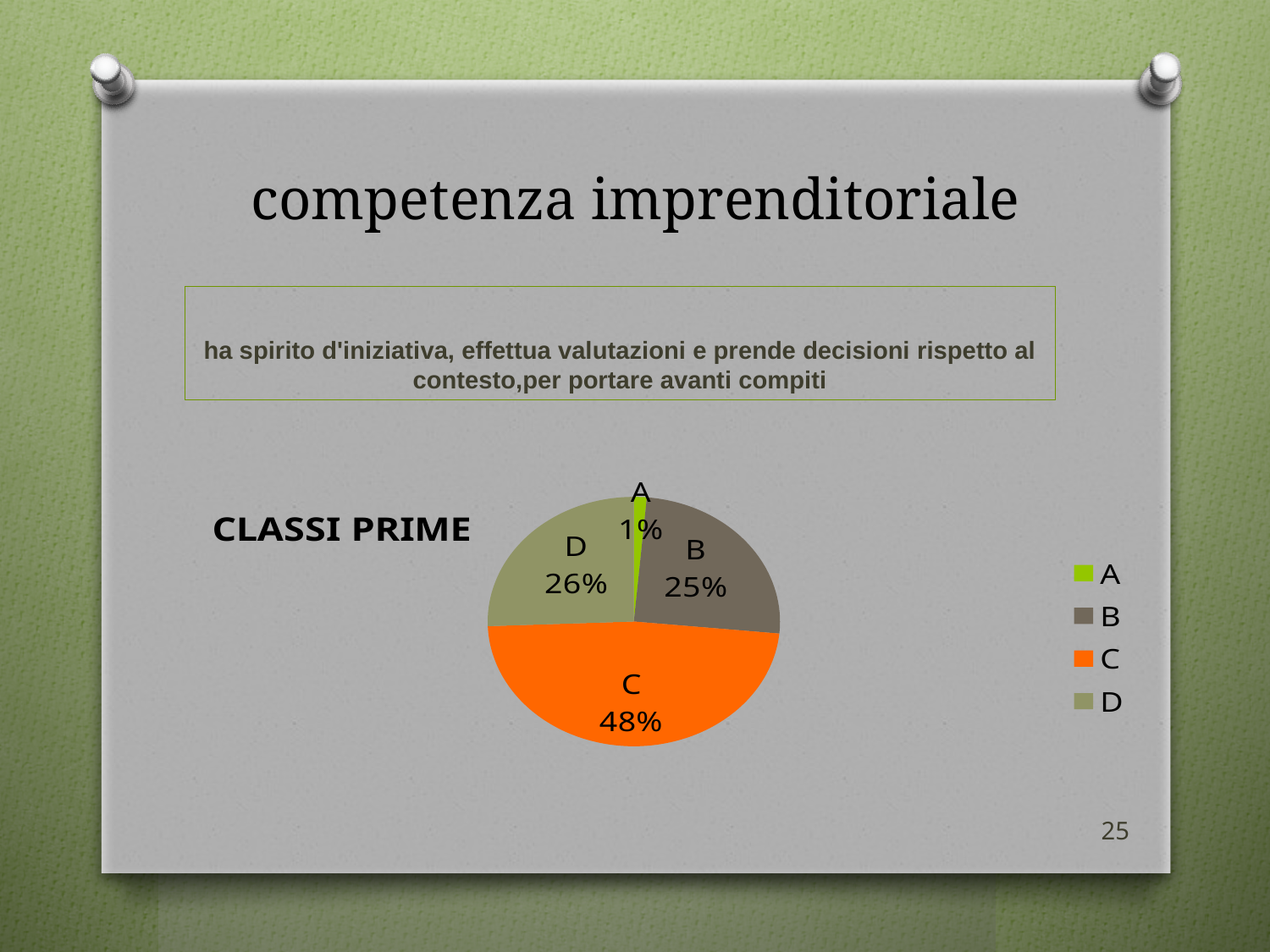
Which category has the smallest share of the pie? A How many entries does the legend list? 4 What percentage does slice B represent? 25% What percentage does slice A represent? 1% What kind of chart is shown on the slide? pie chart How many slices does the pie chart have? 4 What percentage does slice C represent? 48% What is the difference in percentage points between slice C and slice D? 22 What percentage does slice D represent? 26% Which category has the largest share of the pie? C Which is larger, slice C or slice B? C What colour is slice C in the pie chart? orange